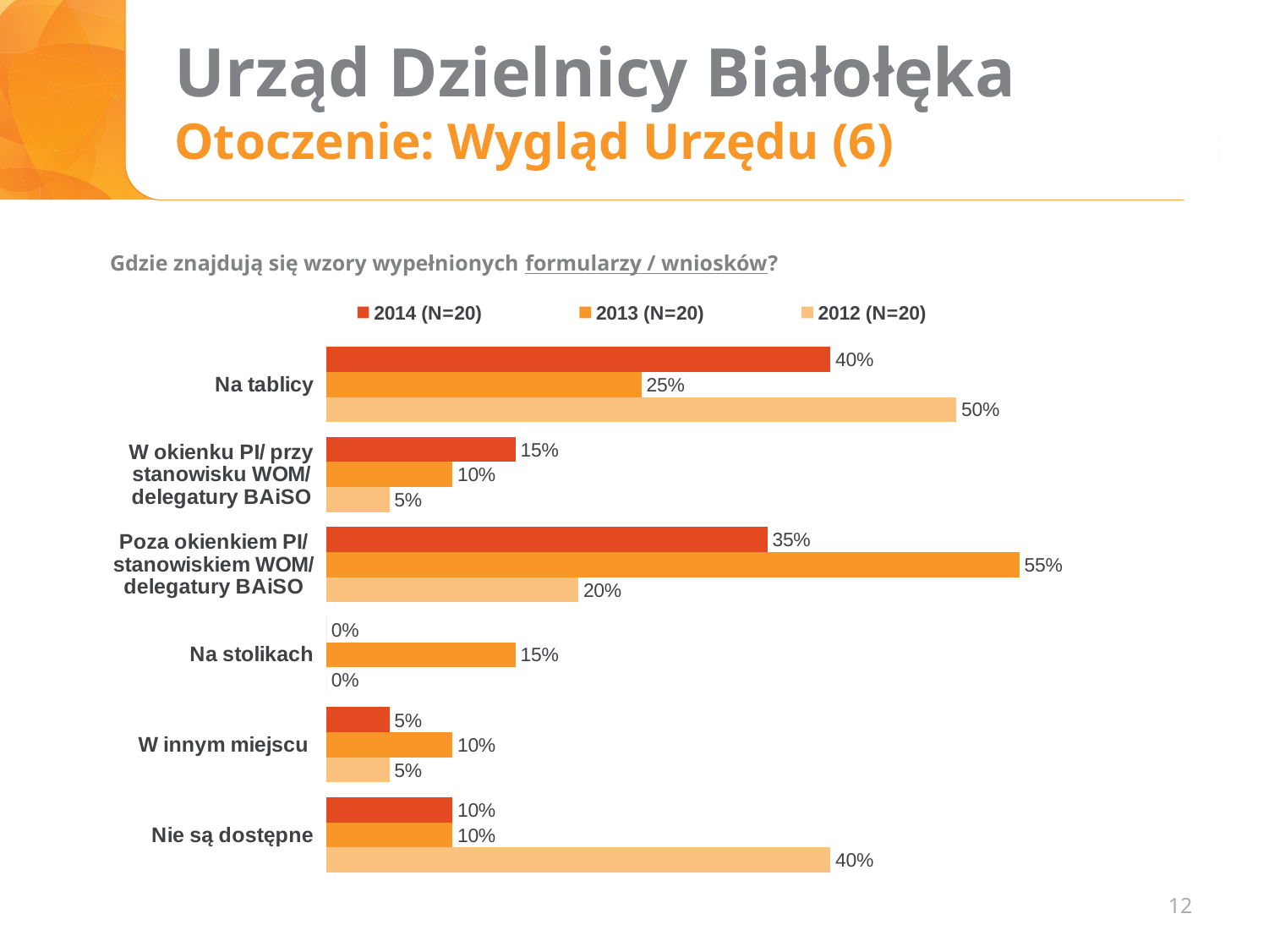
What is the value for "Poza okienkiem PI/ stanowiskiem WOM/ delegatury BAiSO" in the 2013 (N=20) series? 55% What is the value for "Nie są dostępne" in the 2012 (N=20) series? 40% What is the value for "Na stolikach" in the 2014 (N=20) series? 0% How many series does the legend list? 3 What is the value for "Na tablicy" in the 2014 (N=20) series? 40% How many categories are shown on the chart? 6 What question does the chart answer, as stated above it? Gdzie znajdują się wzory wypełnionych formularzy / wniosków? What is the difference between the 2012 (N=20) and 2013 (N=20) values for "Na tablicy"? 25% Which category has the highest value in the 2012 (N=20) series? Na tablicy What kind of chart is shown on the slide? Bar chart Which is larger for "Poza okienkiem PI/ stanowiskiem WOM/ delegatury BAiSO": the 2014 (N=20) value or the 2012 (N=20) value? 2014 (N=20)